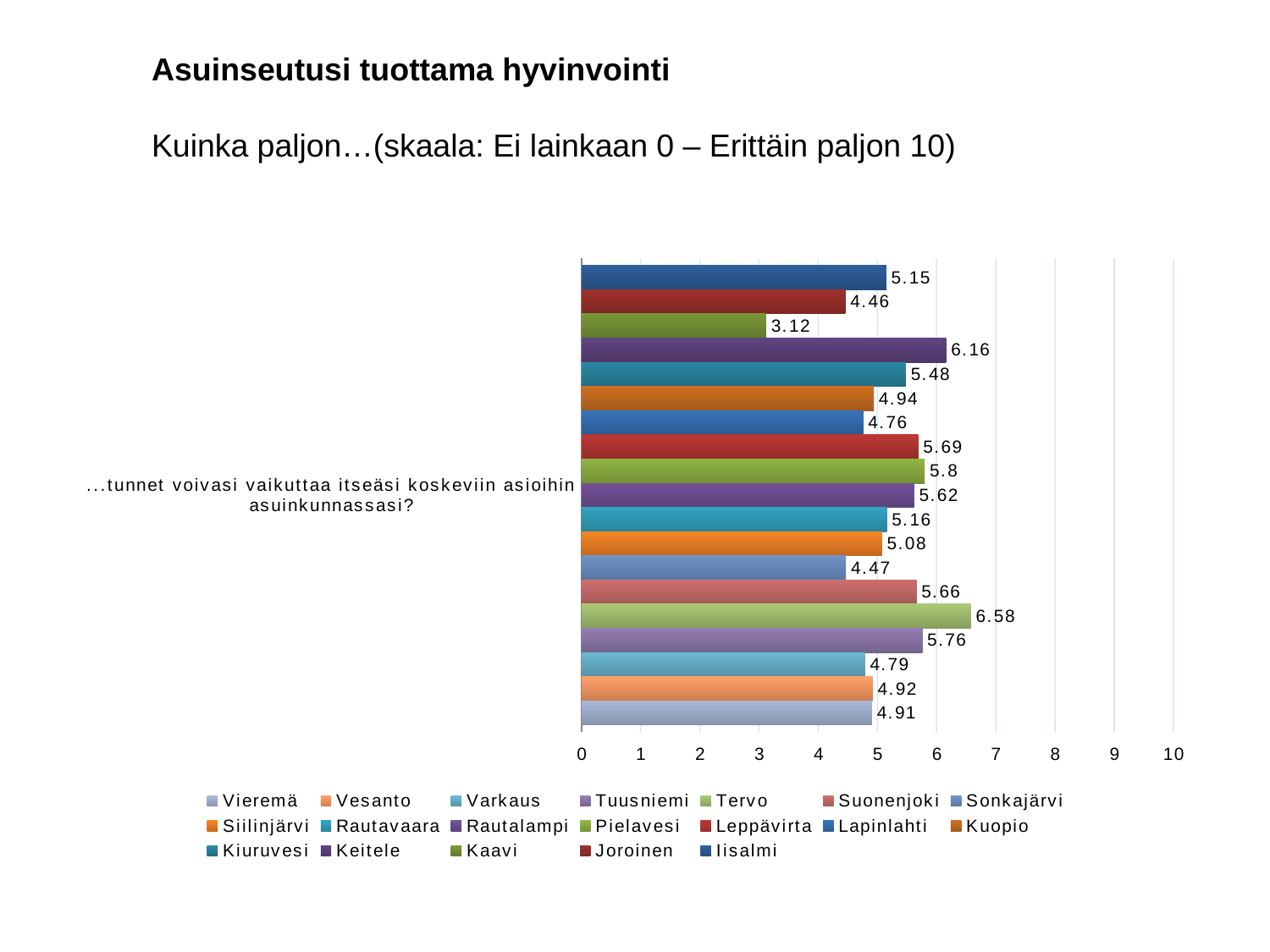
What is the value for Tervo? 6.58 What is the difference between the values for Tervo and Kaavi? 3.46 What is the value for Kaavi? 3.12 How many series does the legend list? 19 Which municipality has the lowest value? Kaavi Which municipality has the highest value? Tervo What is the maximum value shown on the x axis? 10 Which has a larger value, Keitele or Pielavesi? Keitele What is the value for Kuopio? 4.94 What is the value for Iisalmi? 5.15 Is the value for Sonkajärvi greater or less than 5? less What kind of chart is shown on the slide? bar chart